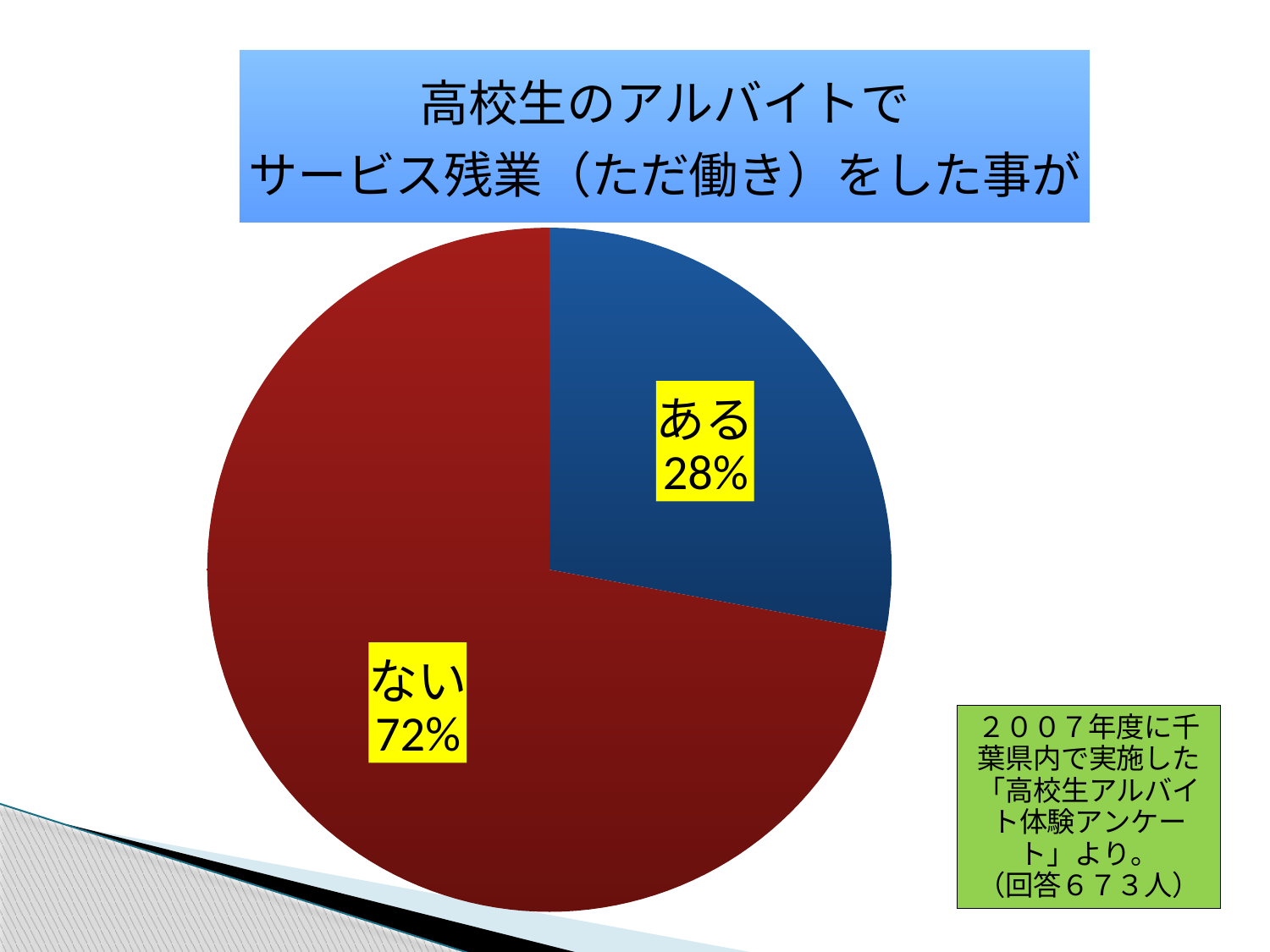
What share of the pie does the ある slice represent? 28% Which slice is the smallest? ある Which slice is the largest? ない What colour is the ない slice? dark red What is the difference in percentage points between the ない slice and the ある slice? 44 How many slices does the pie chart have? 2 What colour is the ある slice? blue What percentage is shown for the ある slice? 28% What percentage is shown for the ない slice? 72% What kind of chart is shown on the slide? pie chart Which is larger, the ある slice or the ない slice? ない